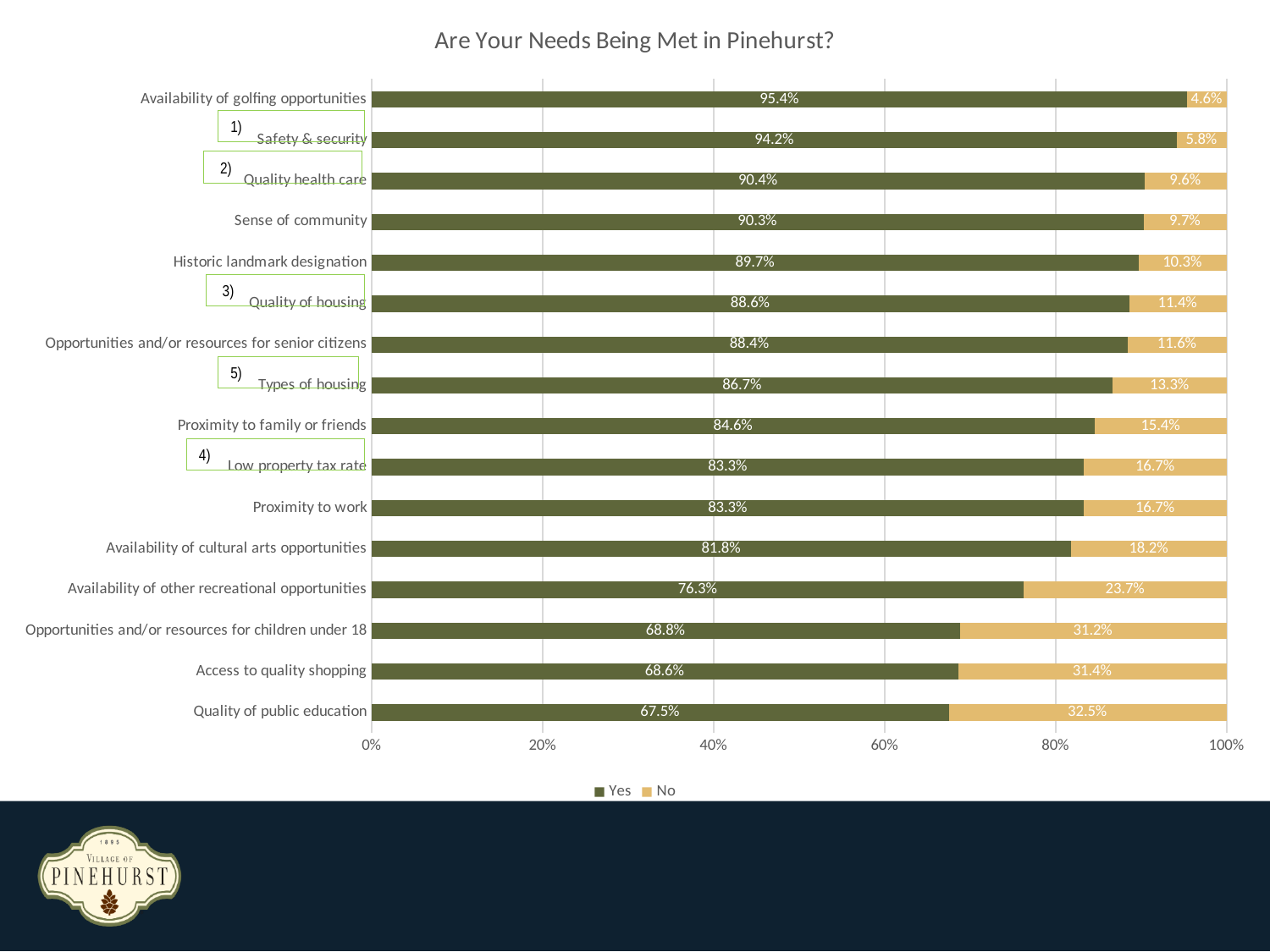
What is the title of the chart? Are Your Needs Being Met in Pinehurst? What type of chart is shown? Stacked bar chart Which category has the highest Yes percentage? Availability of golfing opportunities What is the Yes value for Sense of community? 90.3% What percentage answered Yes for Availability of golfing opportunities? 95.4% What percentage answered No for Quality of public education? 32.5% What is the difference between the Yes percentages for Historic landmark designation and Proximity to work? 6.4% How many series does the legend list? 2 Which category has the lowest Yes percentage? Quality of public education Which has a larger No percentage, Access to quality shopping or Proximity to family or friends? Access to quality shopping How many categories are shown on the chart? 16 What is the No value for Availability of other recreational opportunities? 23.7%